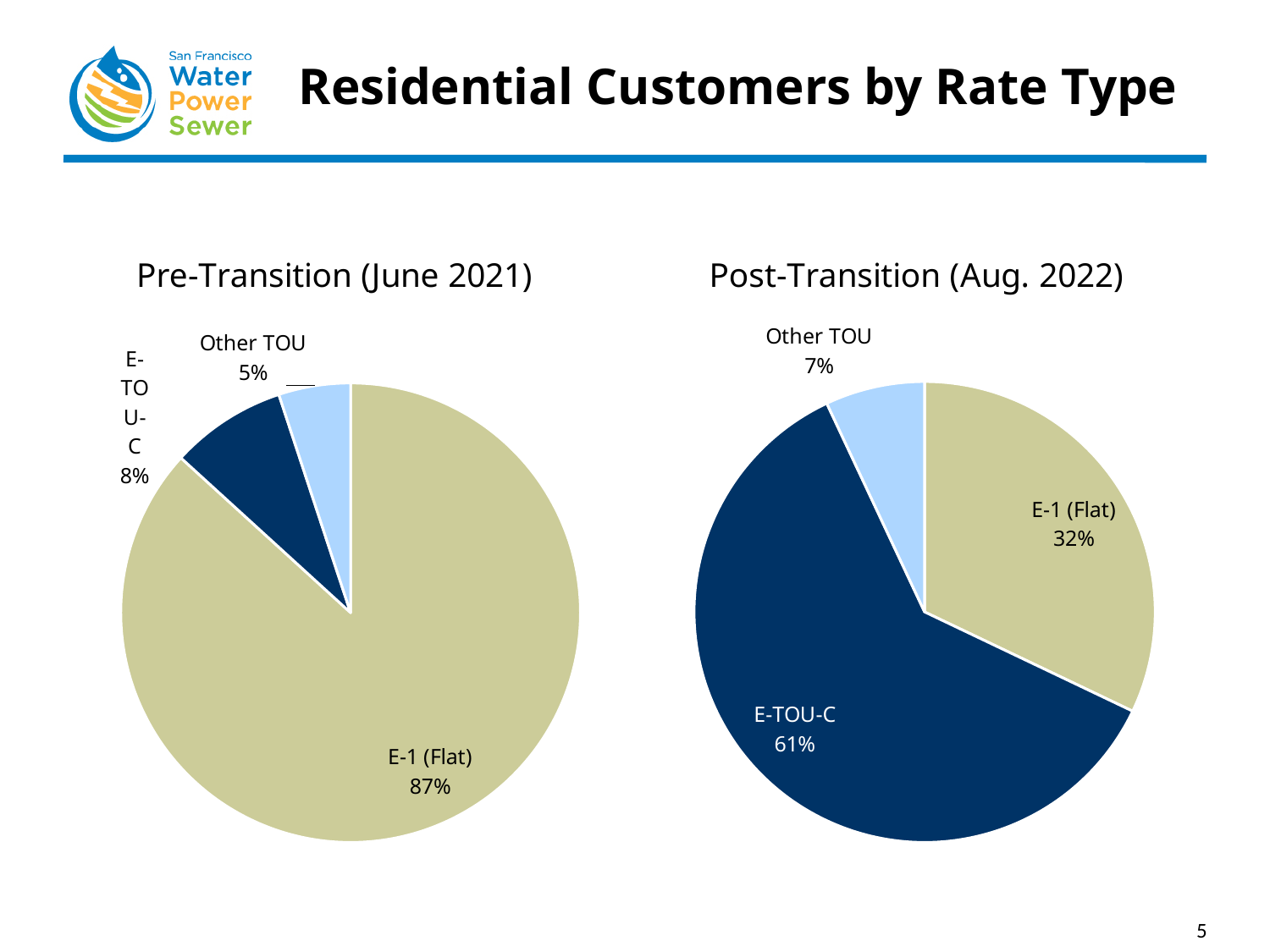
What type of chart is used for the Post-Transition (Aug. 2022) data? Pie chart In the Pre-Transition (June 2021) chart, what share of residential customers are on Other TOU rates? 5% What is the title of the chart on the left side of the slide? Pre-Transition (June 2021) In the Post-Transition (Aug. 2022) chart, which is larger: the E-TOU-C share or the E-1 (Flat) share? E-TOU-C In the Post-Transition (Aug. 2022) chart, what is the difference between the E-TOU-C share and the Other TOU share? 54% In the Post-Transition (Aug. 2022) chart, which rate type has the smallest share? Other TOU In the Pre-Transition (June 2021) chart, which rate type has the largest share? E-1 (Flat) In the Post-Transition (Aug. 2022) chart, what share of residential customers are on the E-1 (Flat) rate? 32% How many slices does the Pre-Transition (June 2021) pie chart have? 3 In the Post-Transition (Aug. 2022) chart, what share of residential customers are on the E-TOU-C rate? 61% In the Pre-Transition (June 2021) chart, what share of residential customers are on the E-1 (Flat) rate? 87% What is the difference between the E-1 (Flat) share in the Pre-Transition (June 2021) chart and the E-1 (Flat) share in the Post-Transition (Aug. 2022) chart? 55%